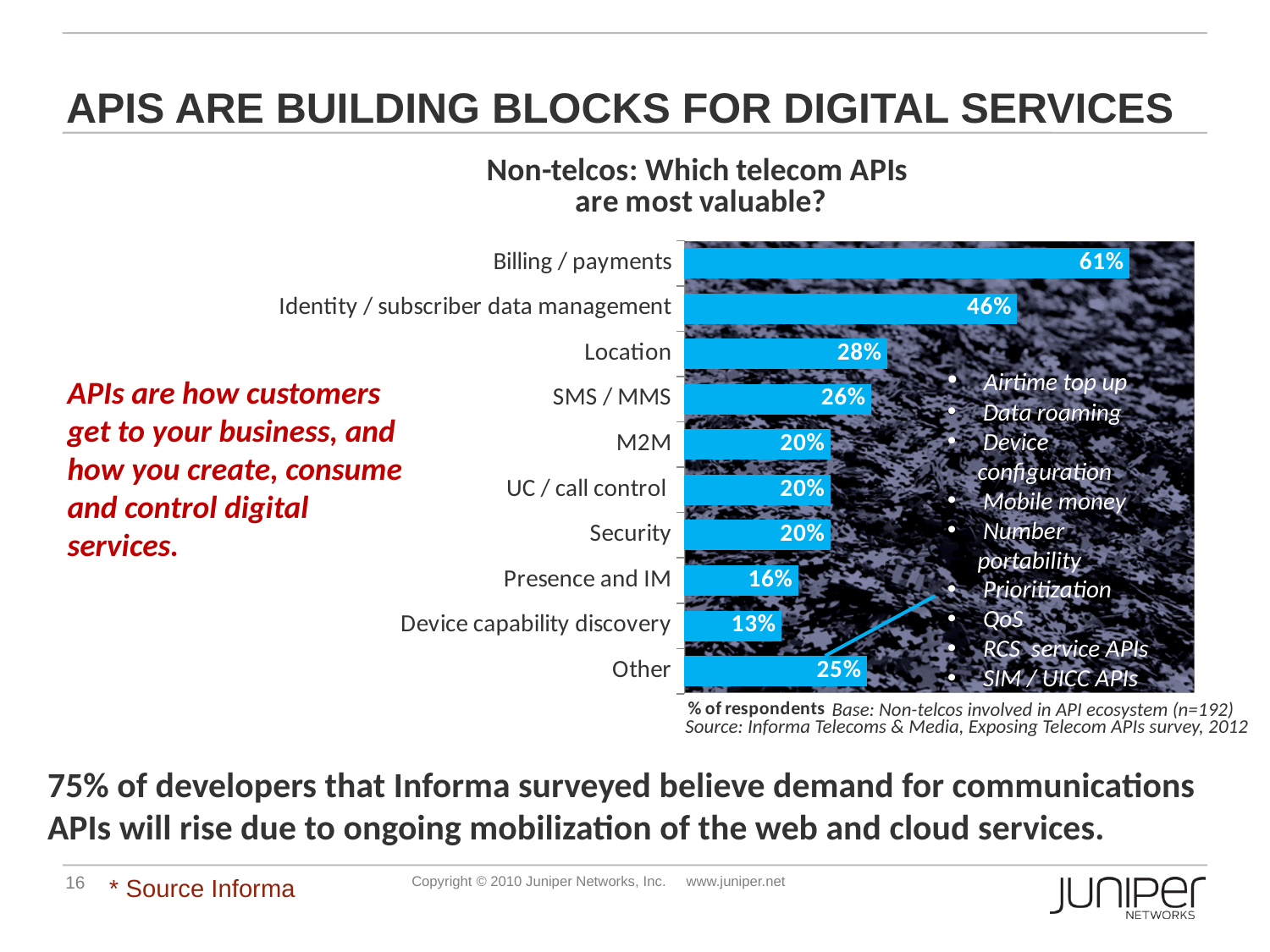
Which is larger, Presence and IM or Other? Other Which category has the lowest value? Device capability discovery What is the difference between Billing / payments and Identity / subscriber data management? 15% What is the value for Billing / payments? 61% How many categories are shown in the chart? 10 Which category has the highest value? Billing / payments What is the difference between Location and SMS / MMS? 2% What is the title of the chart? Non-telcos: Which telecom APIs are most valuable? What kind of chart is this? Bar chart What is the value for Device capability discovery? 13% What is the value for Identity / subscriber data management? 46% What is the value for Other? 25%